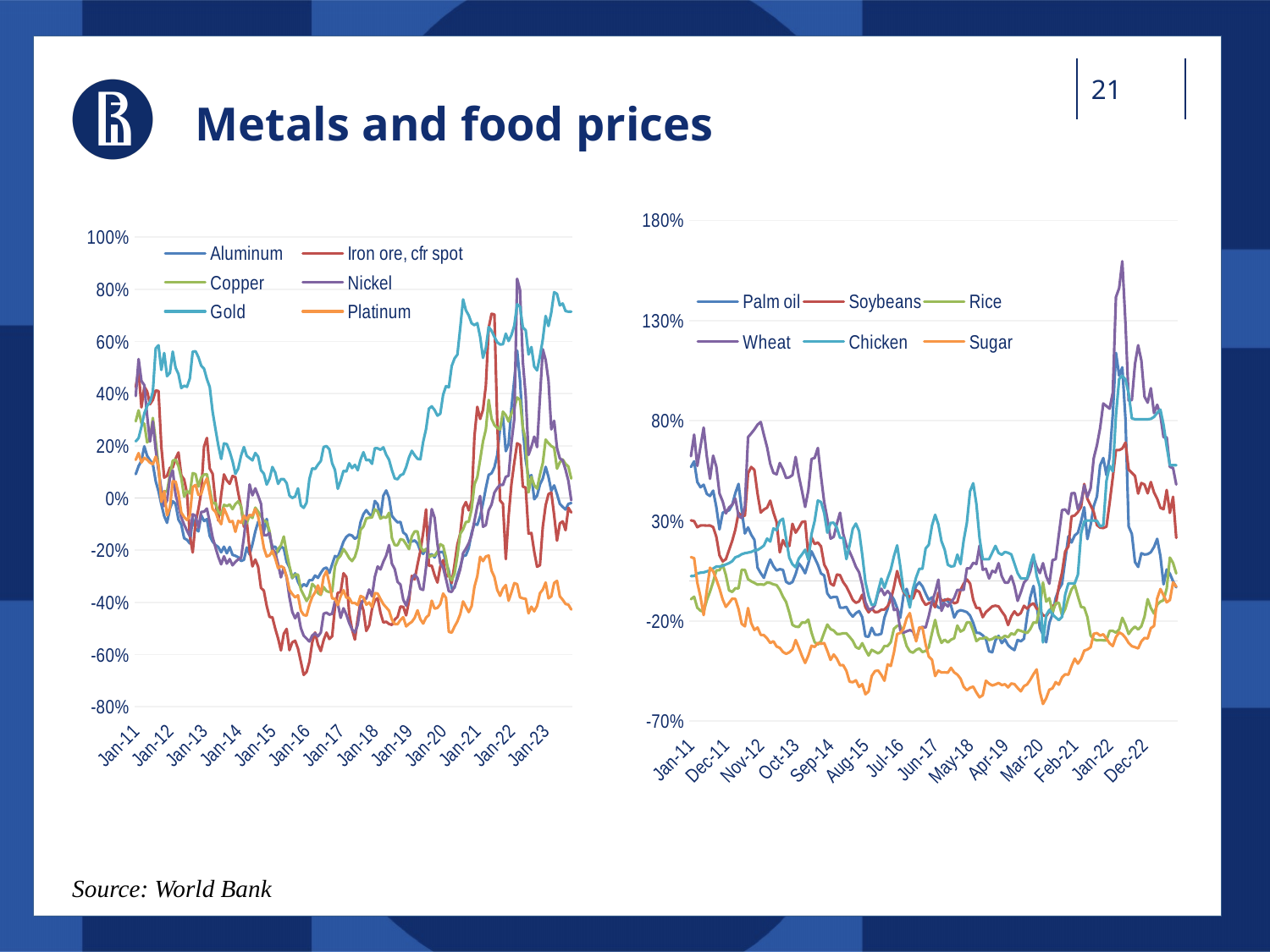
In the right chart, does the Sugar series rise or fall between Jan-11 and Aug-15? fall In the left chart, is the peak value for Gold around Jan-21 greater or less than 60%? greater In the left chart, is the value for Platinum at the end of the series (around Jan-23) greater or less than -20%? less In the left chart, does the Gold series rise or fall between Jan-19 and Jan-21? rise In the right chart, is the value for Rice at Jan-11 greater or less than 30%? less What kind of chart is the left chart on the slide? line chart How many series does the legend of the right chart list? 6 In the right chart, which series is drawn in orange? Sugar How many series does the legend of the left chart list? 6